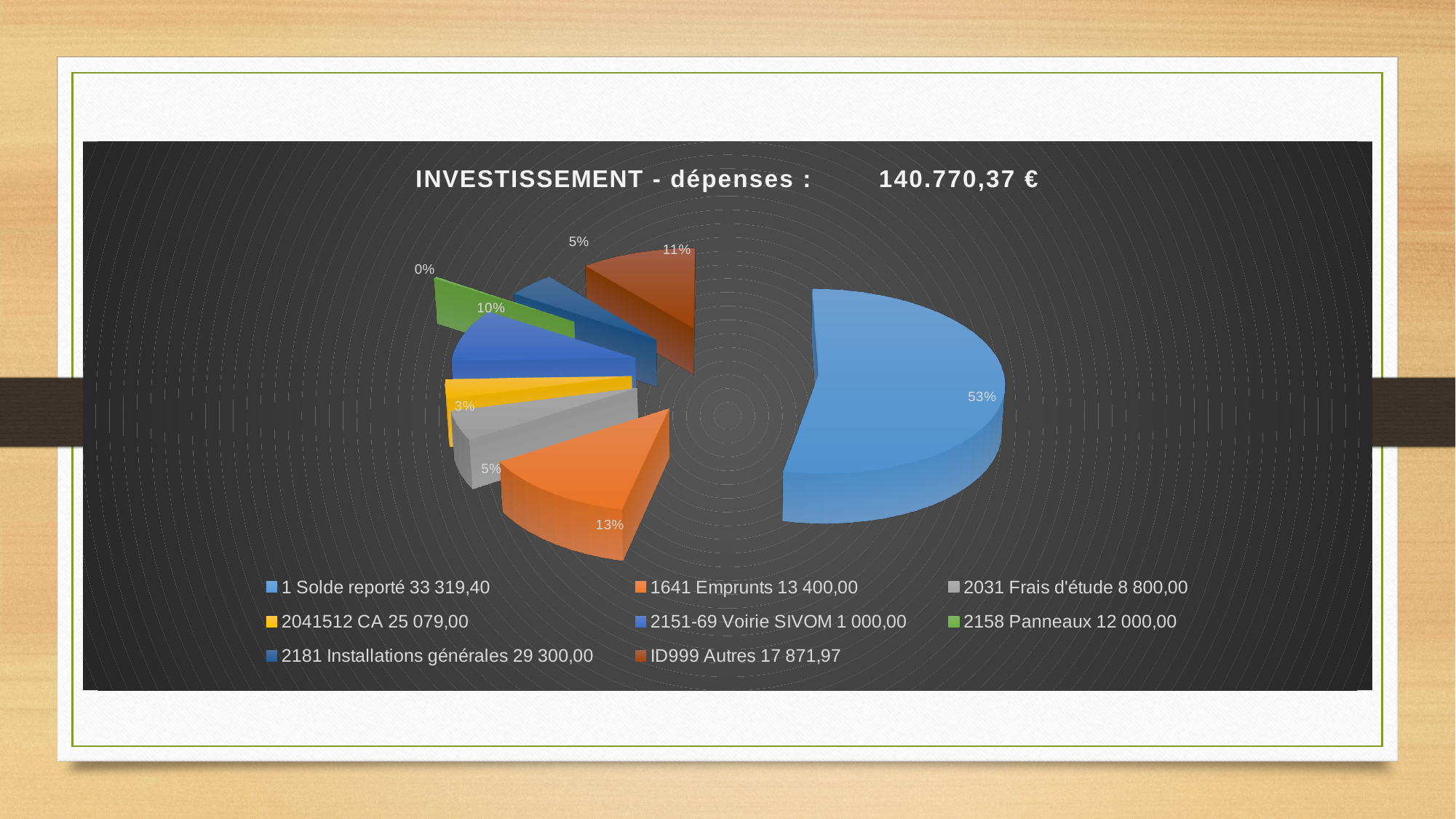
What share of the pie does the slice for 'ID999 Autres' represent? 11% What amount is shown in the legend for '1641 Emprunts'? 13 400,00 What colour is the slice for '1 Solde reporté'? blue What amount is shown in the legend for '2181 Installations générales'? 29 300,00 What kind of chart is shown on the slide? pie chart How many categories does the legend of the pie chart list? 8 What share of the pie does the slice for '1 Solde reporté' represent? 53% What share of the pie does the slice for '1641 Emprunts' represent? 13% What amount is shown in the legend for 'ID999 Autres'? 17 871,97 What is the title of the chart? INVESTISSEMENT - dépenses : 140.770,37 € Which slice is larger, '1641 Emprunts' or 'ID999 Autres'? 1641 Emprunts Which category has the largest slice of the pie? 1 Solde reporté